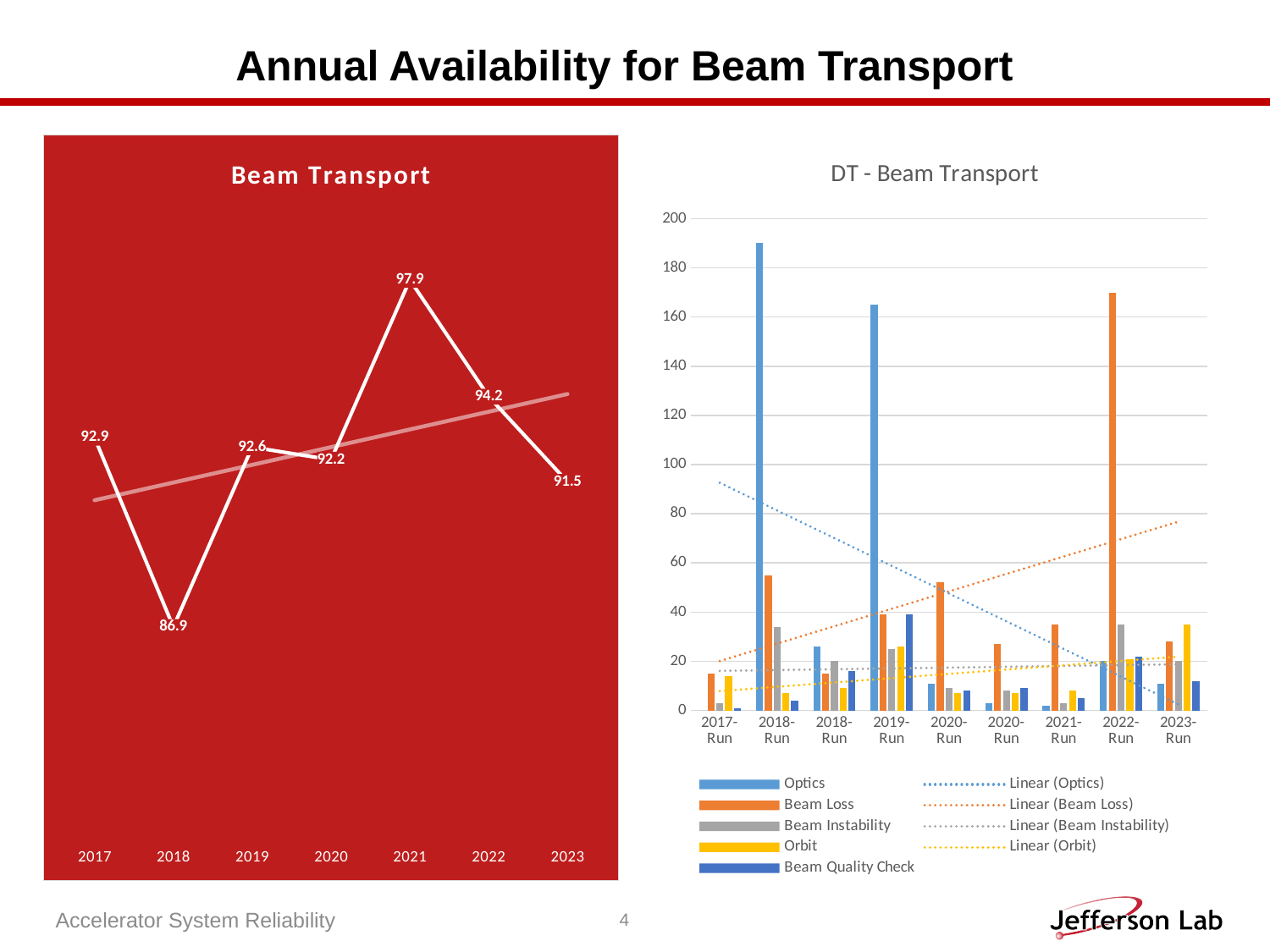
In the DT - Beam Transport chart on the right, is the Optics value for the first 2018-Run category greater or less than 180? greater In the Beam Transport chart on the left, how many years are plotted? 7 What kind of chart is the DT - Beam Transport chart on the right? bar chart In the Beam Transport chart on the left, what is the value for 2018? 86.9 In the Beam Transport chart on the left, what is the difference between the 2022 value and the 2023 value? 2.7 In the Beam Transport chart on the left, which year has the highest value? 2021 In the Beam Transport chart on the left, which is larger, the value for 2017 or the value for 2019? 2017 In the Beam Transport chart on the left, which year has the lowest value? 2018 In the Beam Transport chart on the left, what is the value for 2021? 97.9 In the Beam Transport chart on the left, do the values rise or fall from 2021 to 2023? fall In the Beam Transport chart on the left, what is the difference between the 2021 value and the 2018 value? 11.0 In the DT - Beam Transport chart on the right, which category has the highest Beam Loss bar? 2022-Run